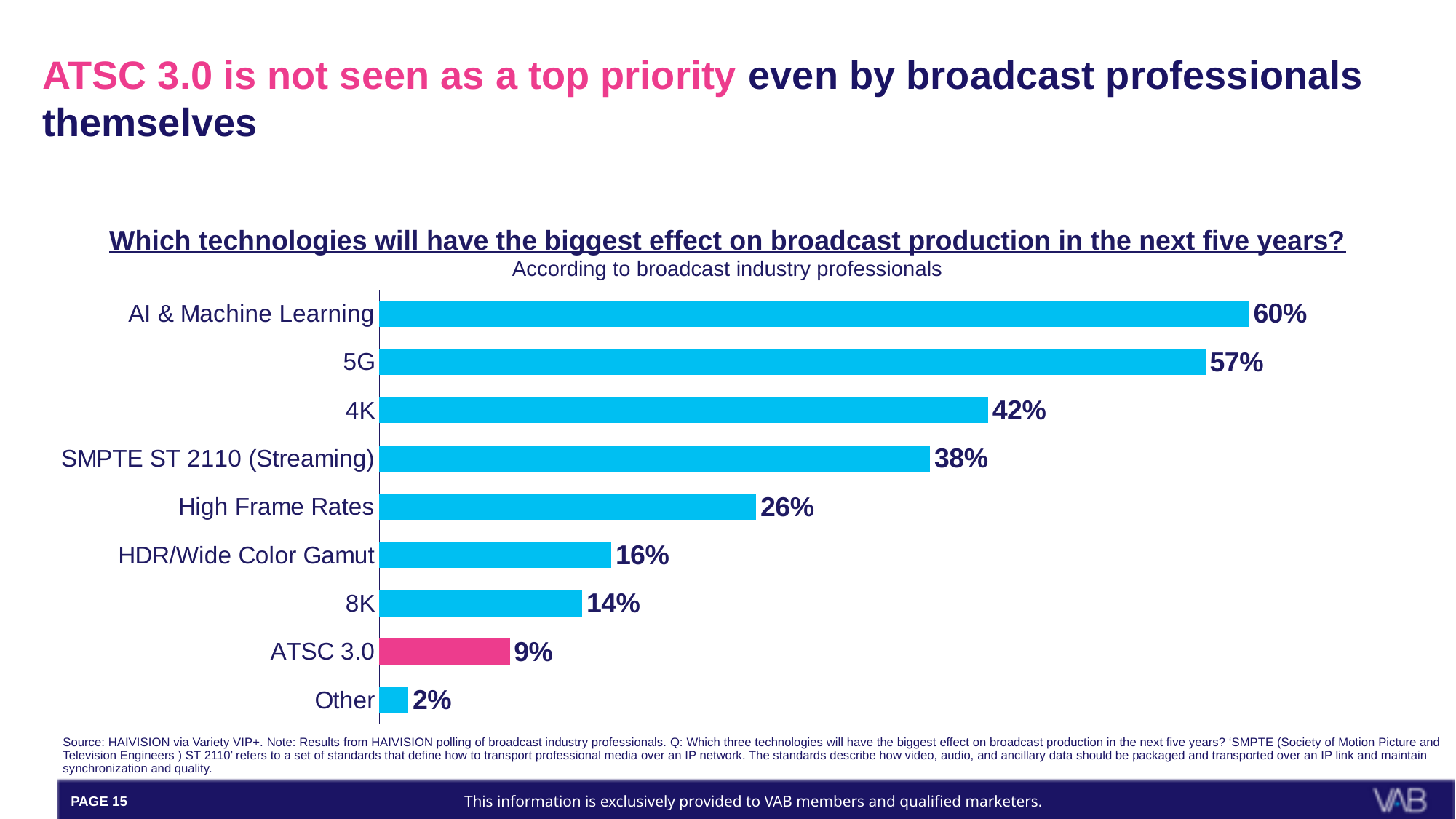
What kind of chart is shown on the slide? Bar chart What is the value shown for ATSC 3.0? 9% Which category has the lowest value on the chart? Other What is the difference between the values for 8K and ATSC 3.0? 5% What is the value shown for SMPTE ST 2110 (Streaming)? 38% Which technology has the highest value on the chart? AI & Machine Learning What is the difference between the values for 5G and 4K? 15% Which bar is highlighted in a different colour (pink) from the others? ATSC 3.0 What percentage of broadcast industry professionals selected AI & Machine Learning? 60% What is the subtitle shown beneath the chart's title question? According to broadcast industry professionals Which has a larger value, High Frame Rates or HDR/Wide Color Gamut? High Frame Rates How many technology categories are shown on the chart? 9